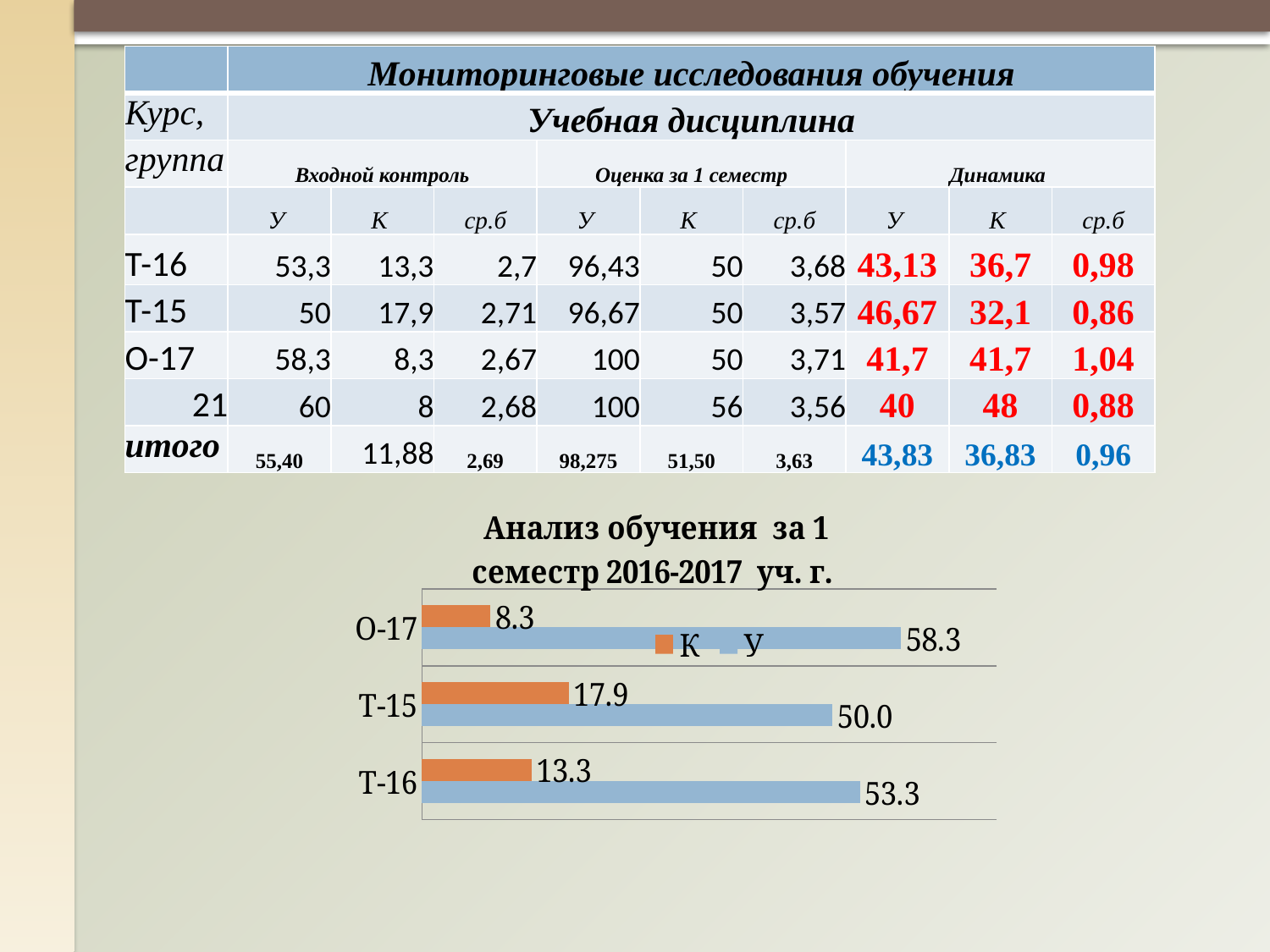
Which group has the highest У value in the chart? О-17 How many series does the chart legend list? 2 What is the value of К for Т-15 in the chart? 17.9 What is the difference between the У and К values for Т-16 in the chart? 40.0 What is the value of У for О-17 in the chart? 58.3 What type of chart is shown on the slide? bar chart Which group has the lowest К value in the chart? О-17 What is the value of У for Т-15 in the chart? 50.0 Which is larger in the chart: the К value for Т-15 or the К value for Т-16? К for Т-15 How many groups (categories) are shown in the chart? 3 What is the value of К for Т-16 in the chart? 13.3 What is the title of the chart? Анализ обучения за 1 семестр 2016-2017 уч. г.